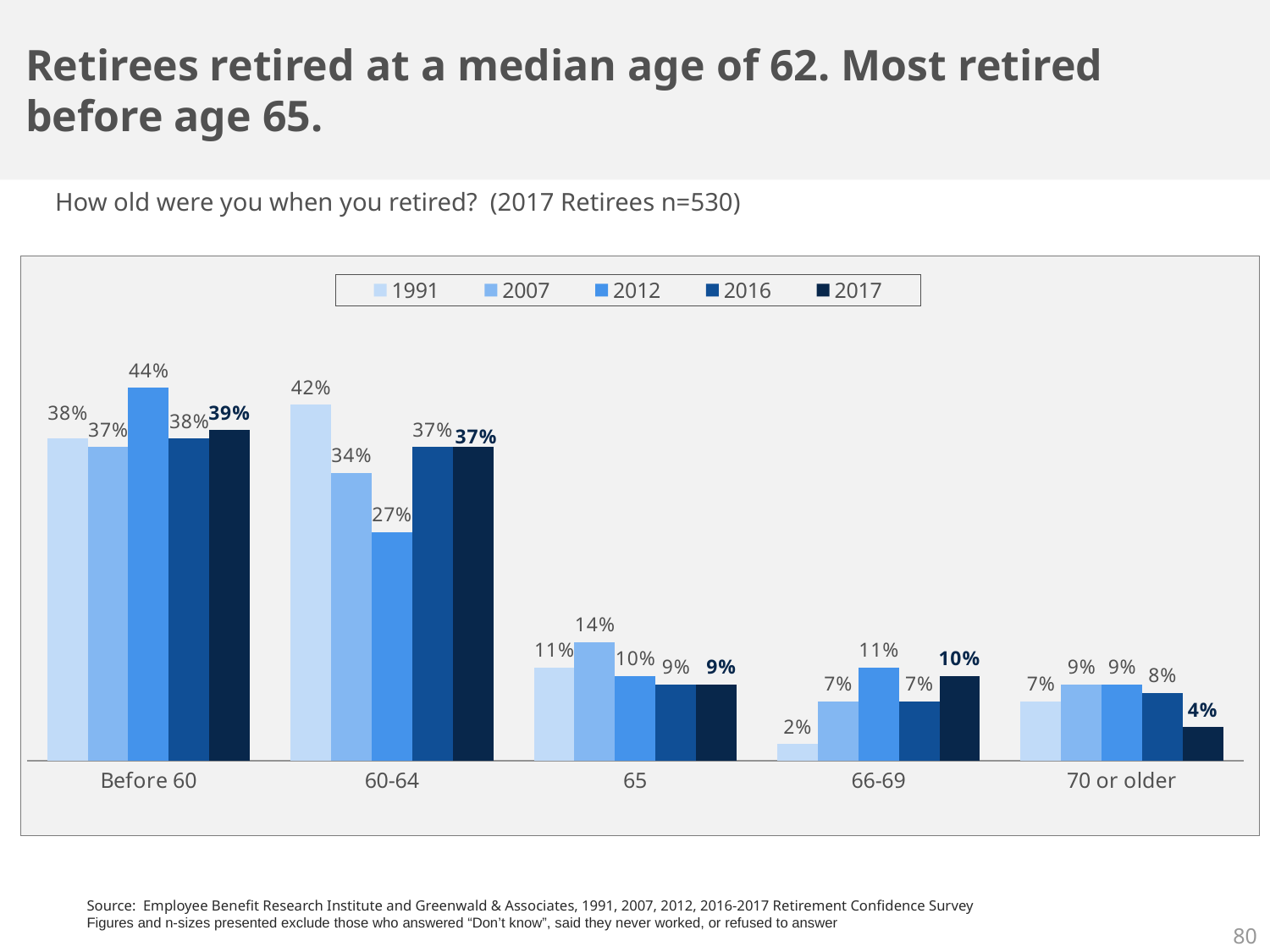
What is the value for the 2012 series in the 60-64 category? 27% What kind of chart is shown on the slide? Bar chart What is the total of the 2017 values for Before 60 and 60-64 combined? 76% How many series does the legend list? 5 Which is larger: the 2007 value for age 65 or the 2017 value for age 65? 2007 What is the value for 1991 in the 66-69 category? 2% Which year has the lowest value in the 60-64 category? 2012 Which year has the highest value in the Before 60 category? 2012 What is the value for 2017 in the 70 or older category? 4% What percentage of 2017 retirees retired before age 60? 39% How many age categories are shown on the x axis? 5 What is the difference between the 1991 and 2012 values in the 60-64 category? 15%